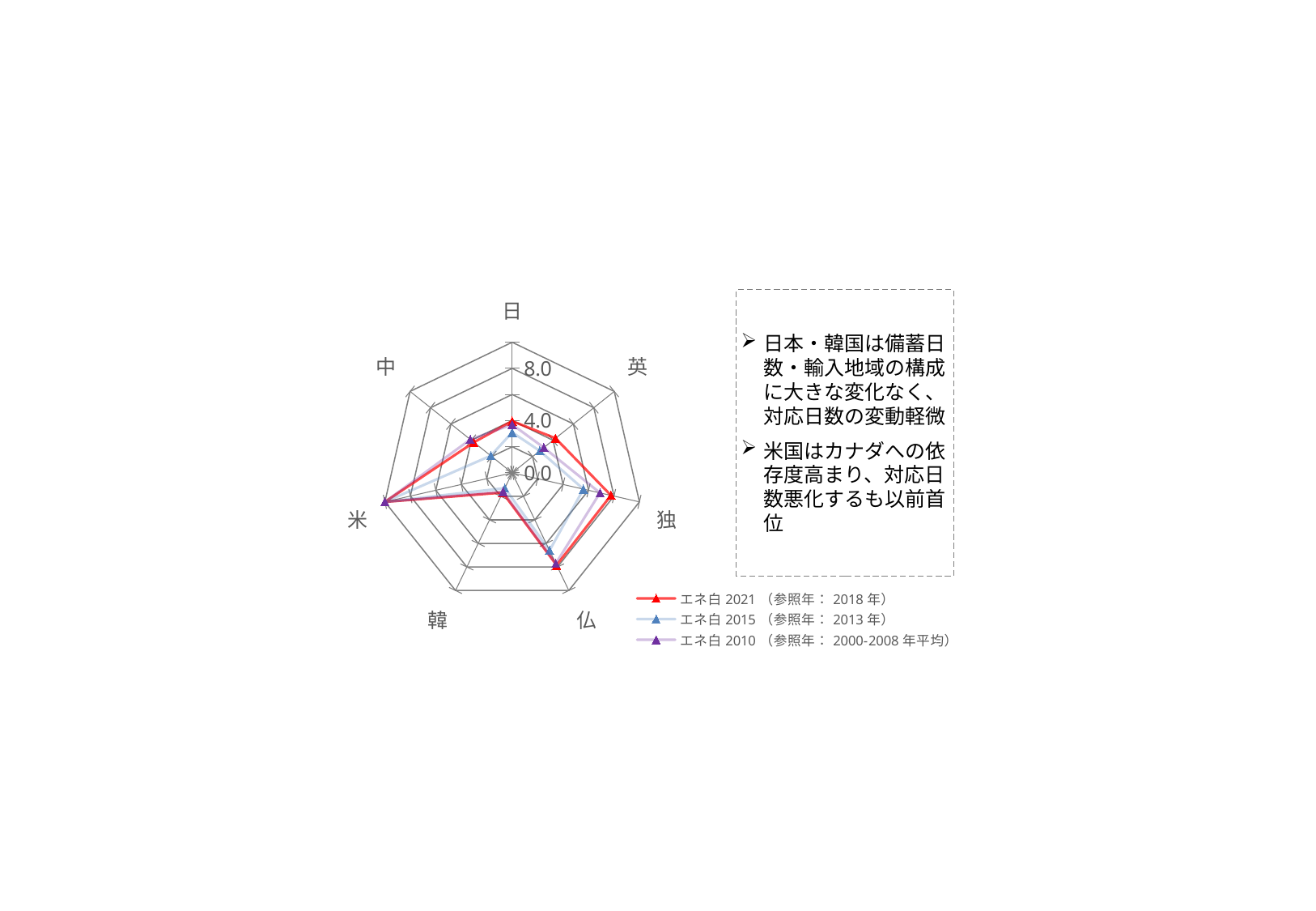
Which country has the highest value for the エネ白 2021 series? 米 Is the value for 韓 in the エネ白 2021 series greater or less than 4.0? less What kind of chart is shown on the slide? Radar chart According to the legend, what is the reference year (参照年) for the エネ白 2015 series? 2013年 For the エネ白 2021 series, which is larger: the value for 独 or the value for 英? 独 Which country has the lowest value for the エネ白 2021 series? 韓 How many categories (countries) are plotted on the radar chart? 7 How many series does the legend list? 3 Is the value for 英 in the エネ白 2015 series greater or less than 4.0? less For 独, which series has the larger value: エネ白 2021 or エネ白 2015? エネ白 2021 Is the value for 米 in the エネ白 2021 series greater or less than 8.0? greater